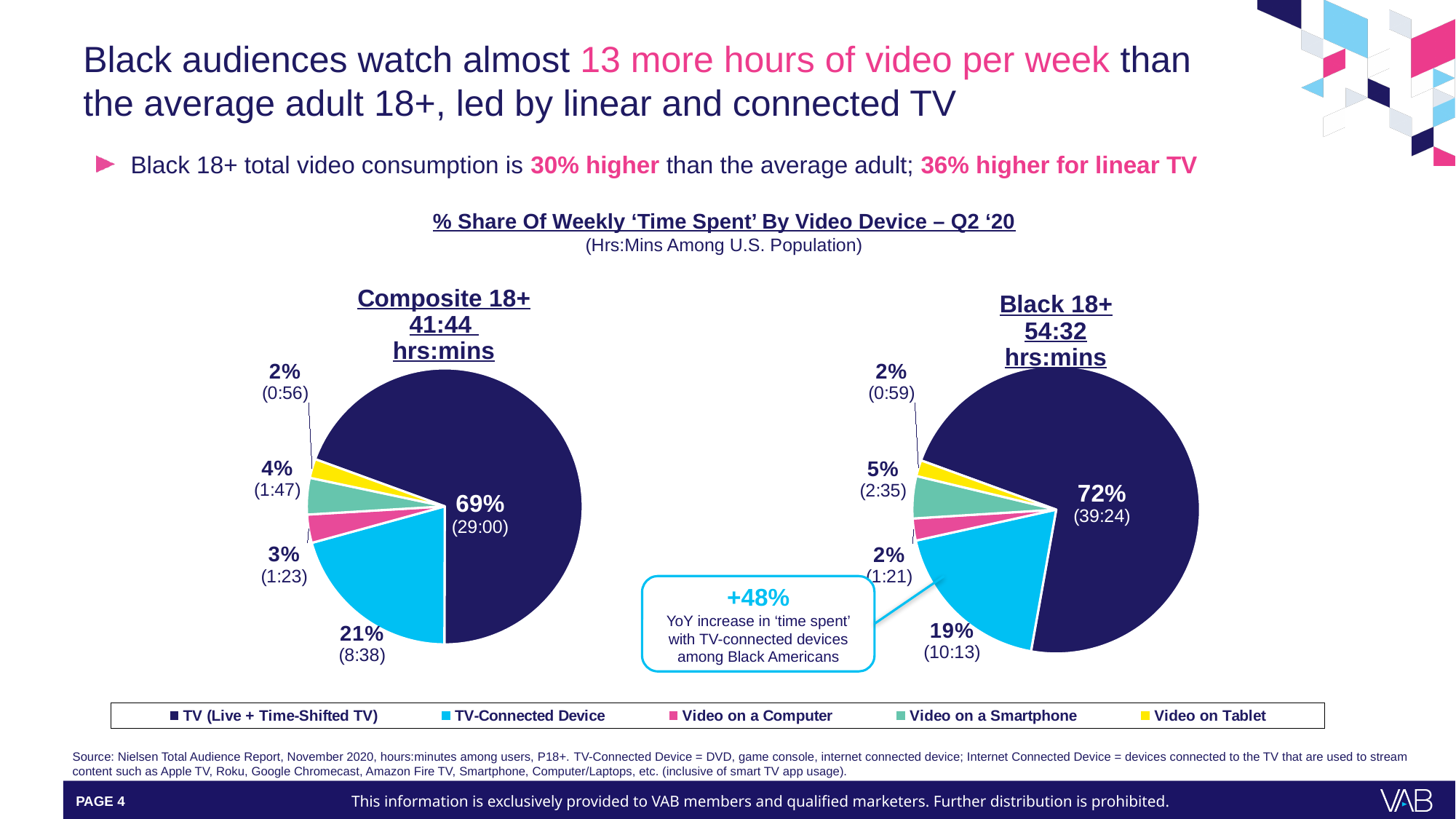
In the Black 18+ pie chart, which device has the largest share of weekly time spent? TV (Live + Time-Shifted TV) In the Composite 18+ pie chart, what is the hours:minutes value for Video on a Smartphone? 1:47 Which is larger: the Video on a Smartphone share in the Black 18+ chart or in the Composite 18+ chart? Black 18+ In the Composite 18+ pie chart, what share of weekly time spent is TV (Live + Time-Shifted TV)? 69% What total weekly hours:mins is shown above the Black 18+ pie chart? 54:32 In the Black 18+ pie chart, how many hours:minutes are spent on TV (Live + Time-Shifted TV)? 39:24 In the Composite 18+ pie chart, which device has the smallest share of weekly time spent? Video on Tablet What colour represents TV-Connected Device in the pie charts? Light blue What kind of charts are shown on the slide? Pie charts How many series does the legend list? 5 What is the difference in percentage points between the TV (Live + Time-Shifted TV) share in the Black 18+ chart and in the Composite 18+ chart? 3 percentage points In the Black 18+ pie chart, what share of weekly time spent is TV-Connected Device? 19%